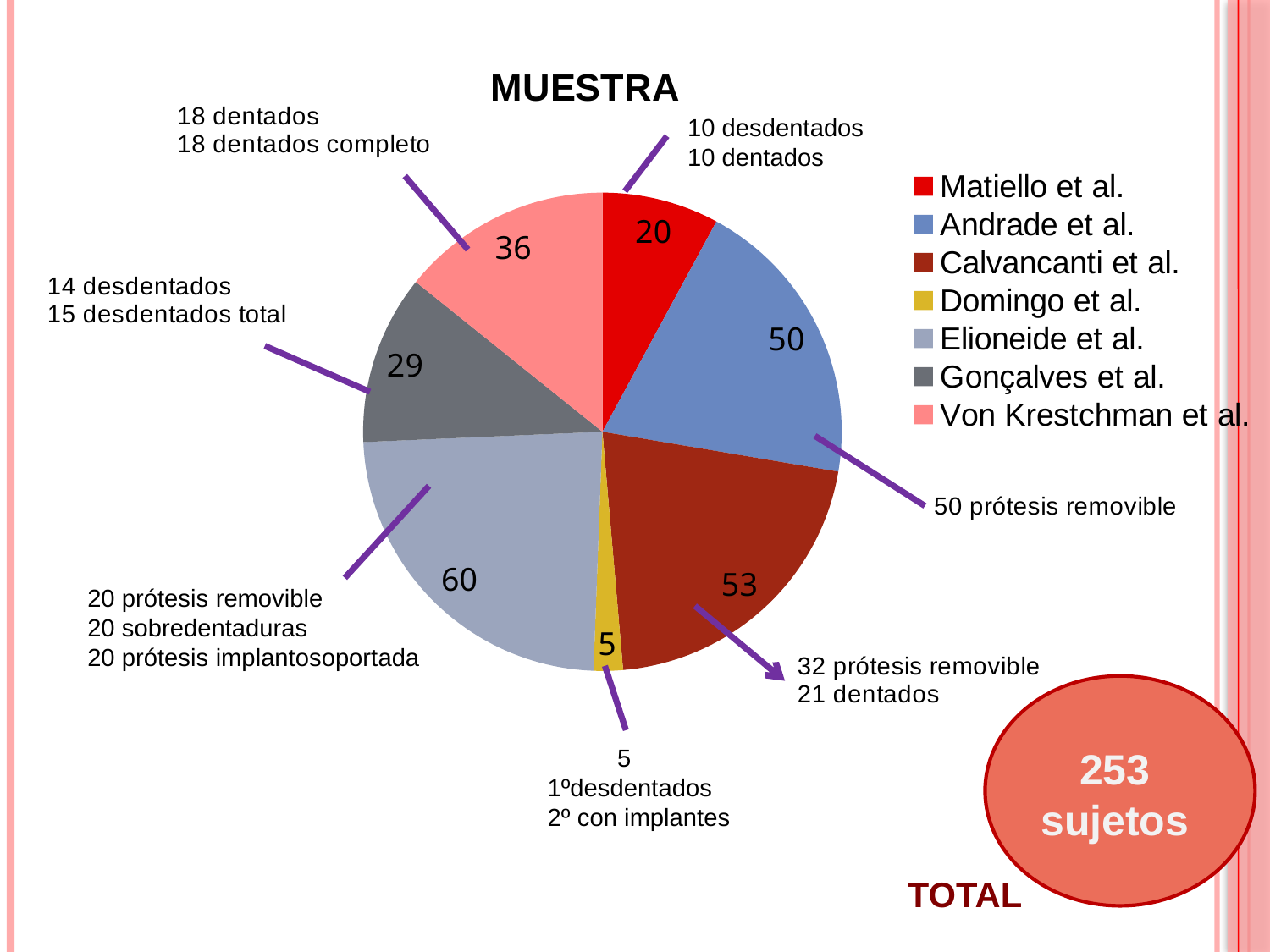
Which study has the largest slice in the pie chart? Elioneide et al. Which is larger, the Calvancanti et al. slice or the Andrade et al. slice? Calvancanti et al. What is the difference between the Elioneide et al. value and the Calvancanti et al. value? 7 What is the title of the pie chart? MUESTRA What is the difference between the Von Krestchman et al. value and the Gonçalves et al. value? 7 What is the value of the Andrade et al. slice? 50 What is the value of the Gonçalves et al. slice? 29 Which study has the smallest slice in the pie chart? Domingo et al. What kind of chart is shown on the slide? pie chart What is the total of all the slice values in the pie chart? 253 How many slices does the pie chart have? 7 What is the value of the Domingo et al. slice? 5